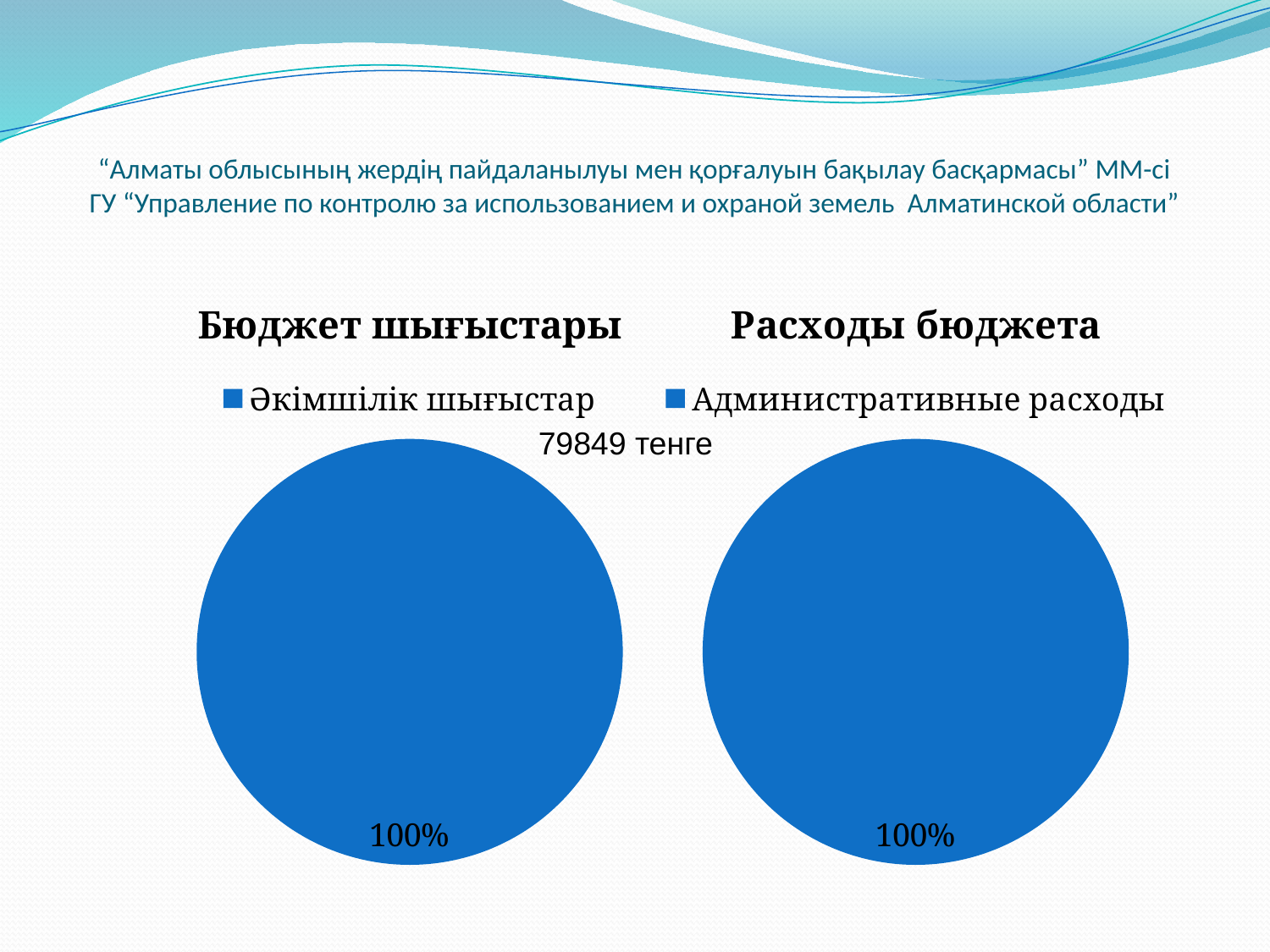
How many slices does the right chart "Расходы бюджета" have? 1 In the left chart "Бюджет шығыстары", what share of the pie does "Әкімшілік шығыстар" take? 100% What is the legend entry of the right chart "Расходы бюджета"? Административные расходы What kind of chart is the right chart titled "Расходы бюджета"? pie chart In the right chart "Расходы бюджета", what share of the pie does "Административные расходы" take? 100% What is the title of the left chart? Бюджет шығыстары What kind of chart is the left chart titled "Бюджет шығыстары"? pie chart How many entries does the legend of the left chart "Бюджет шығыстары" list? 1 How many slices does the left chart "Бюджет шығыстары" have? 1 How many entries does the legend of the right chart "Расходы бюджета" list? 1 How many charts are shown on the slide? 2